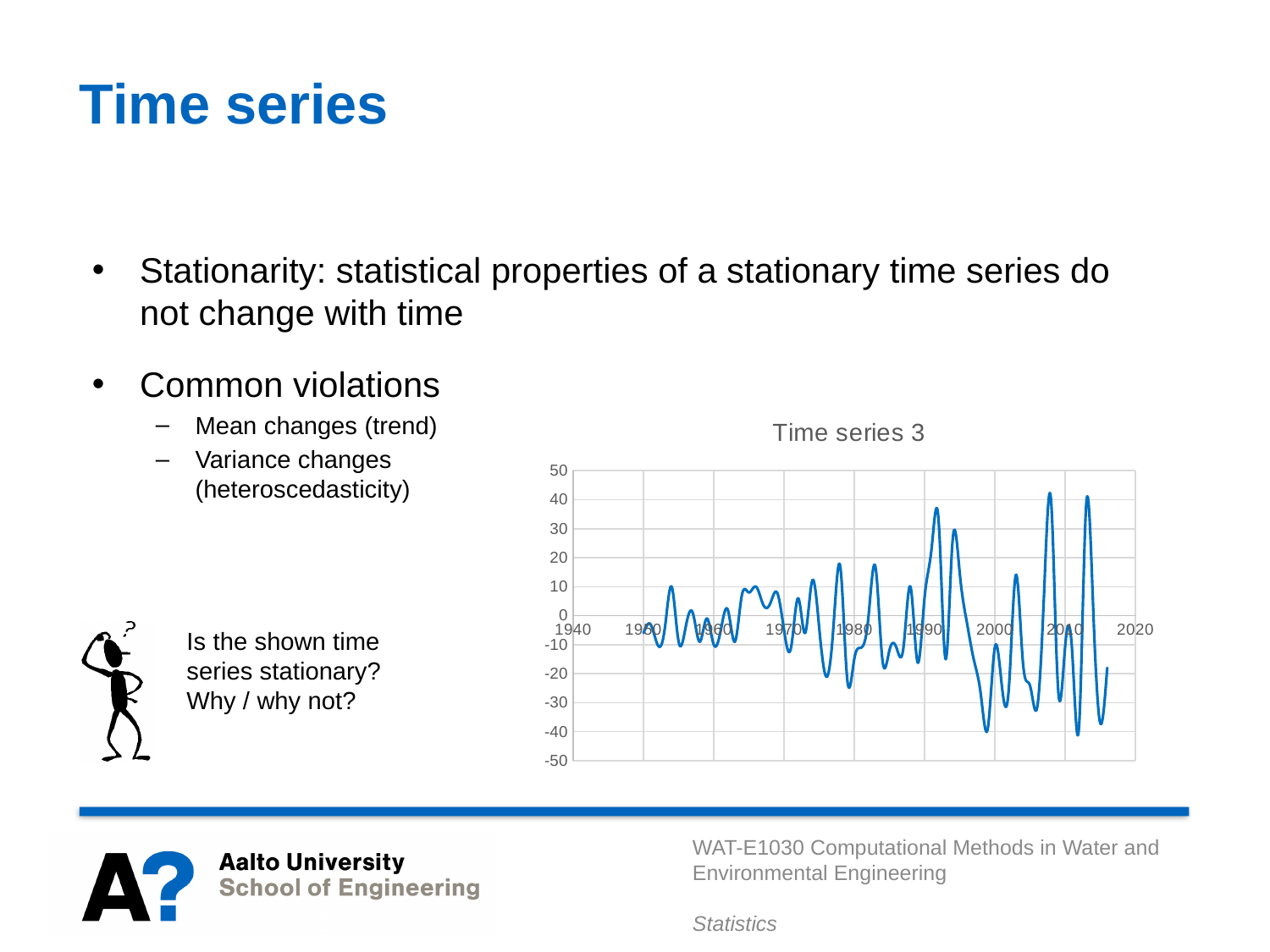
What is the title of the chart on the slide? Time series 3 In the Time series 3 chart, is the peak value around 1992 greater or less than 30? greater In the Time series 3 chart, is the peak value around 1965 greater or less than 20? less In the Time series 3 chart, is the lowest value around 1997 greater or less than -30? less What is the last year label on the x axis of the Time series 3 chart? 2020 What is the highest value shown on the y axis of the Time series 3 chart? 50 In the Time series 3 chart, does the size of the fluctuations increase or decrease as time goes on? increase How many lines (series) are plotted in the Time series 3 chart? 1 What kind of chart is shown on the slide? line chart What is the lowest value shown on the y axis of the Time series 3 chart? -50 What is the first year label on the x axis of the Time series 3 chart? 1940